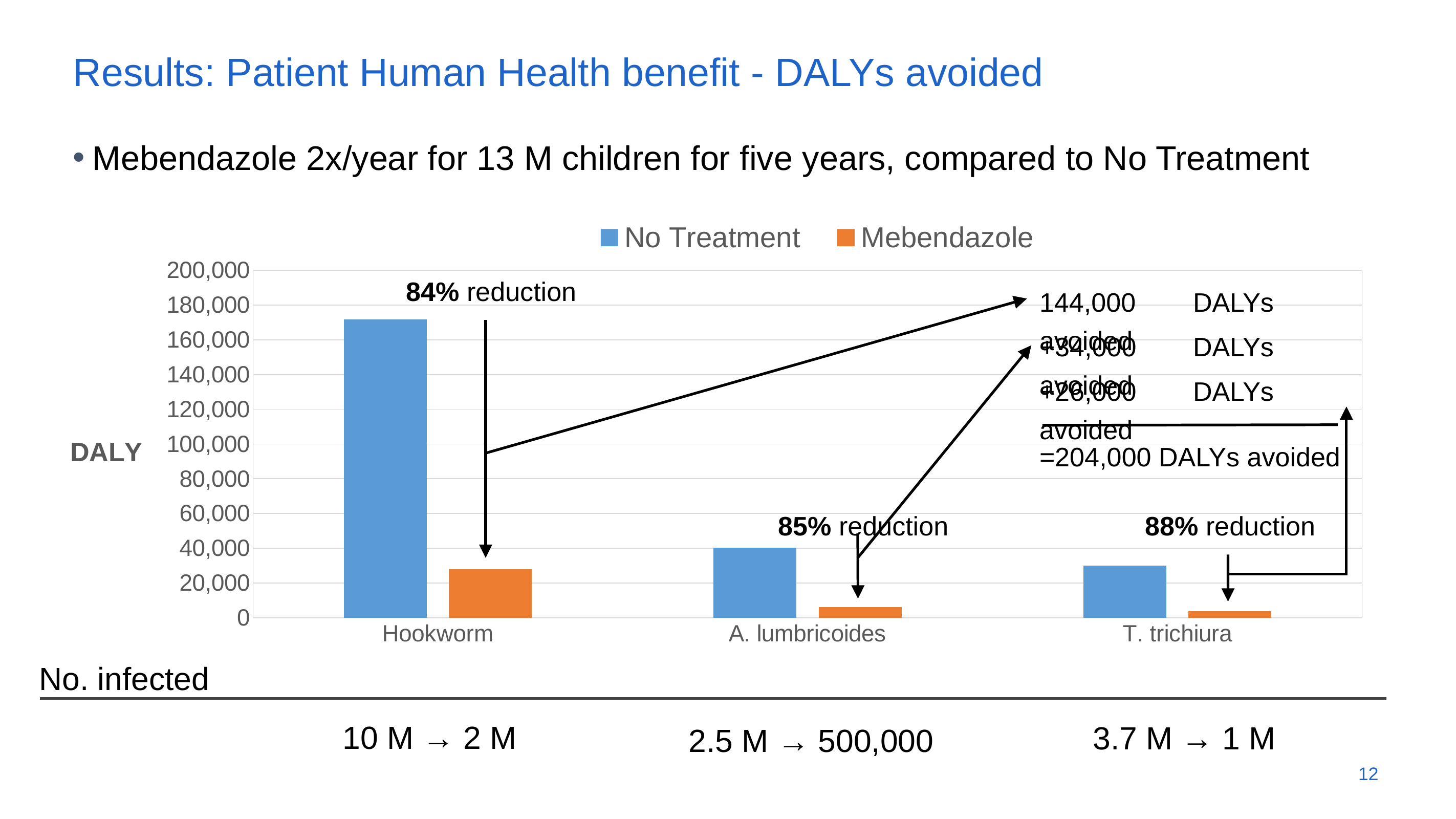
How many series does the chart legend list? 2 Which is larger for A. lumbricoides: the No Treatment bar or the Mebendazole bar? No Treatment Which category has the highest No Treatment bar? Hookworm Is the No Treatment value for T. trichiura greater or less than 40,000? less Is the No Treatment value for Hookworm greater or less than 160,000? greater According to the annotation, what is the total number of DALYs avoided across all three infections? 204,000 According to the annotation, what percentage reduction in DALYs does Mebendazole give for Hookworm? 84% Which category has the lowest No Treatment bar? T. trichiura How many categories are shown on the x axis of the chart? 3 Which colour represents the Mebendazole series in the chart? orange Is the Mebendazole value for Hookworm greater or less than 40,000? less What kind of chart is shown on the slide? bar chart